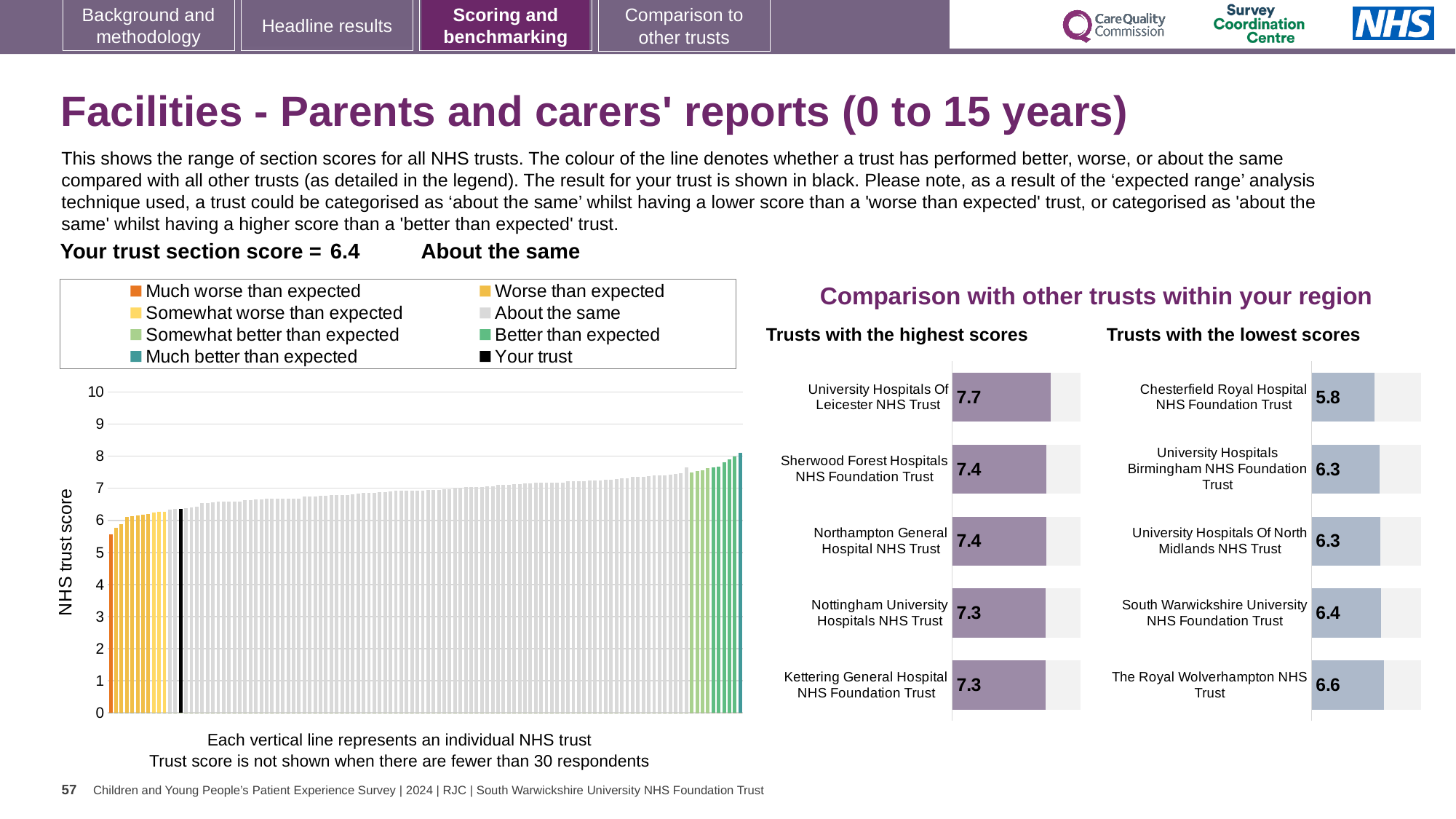
How many entries does the legend of the main NHS trust score chart list? 8 In the 'Trusts with the highest scores' chart, which trust has the highest score? University Hospitals Of Leicester NHS Trust In the 'Trusts with the lowest scores' chart, what is the score for Chesterfield Royal Hospital NHS Foundation Trust? 5.8 In the 'Trusts with the highest scores' chart, what is the score for University Hospitals Of Leicester NHS Trust? 7.7 In the 'Trusts with the highest scores' chart, which has the higher score: Sherwood Forest Hospitals NHS Foundation Trust or Nottingham University Hospitals NHS Trust? Sherwood Forest Hospitals NHS Foundation Trust What kind of chart is the main chart showing NHS trust scores on the left of the slide? bar chart In the 'Trusts with the lowest scores' chart, what is the score for South Warwickshire University NHS Foundation Trust? 6.4 In the 'Trusts with the highest scores' chart, what is the difference between the scores of University Hospitals Of Leicester NHS Trust and Kettering General Hospital NHS Foundation Trust? 0.4 In the 'Trusts with the lowest scores' chart, which trust has the lowest score? Chesterfield Royal Hospital NHS Foundation Trust In the main NHS trust score chart, what colour is used to show your trust? black How many trusts are shown in the 'Trusts with the highest scores' chart? 5 In the 'Trusts with the lowest scores' chart, what is the difference between the scores of The Royal Wolverhampton NHS Trust and Chesterfield Royal Hospital NHS Foundation Trust? 0.8